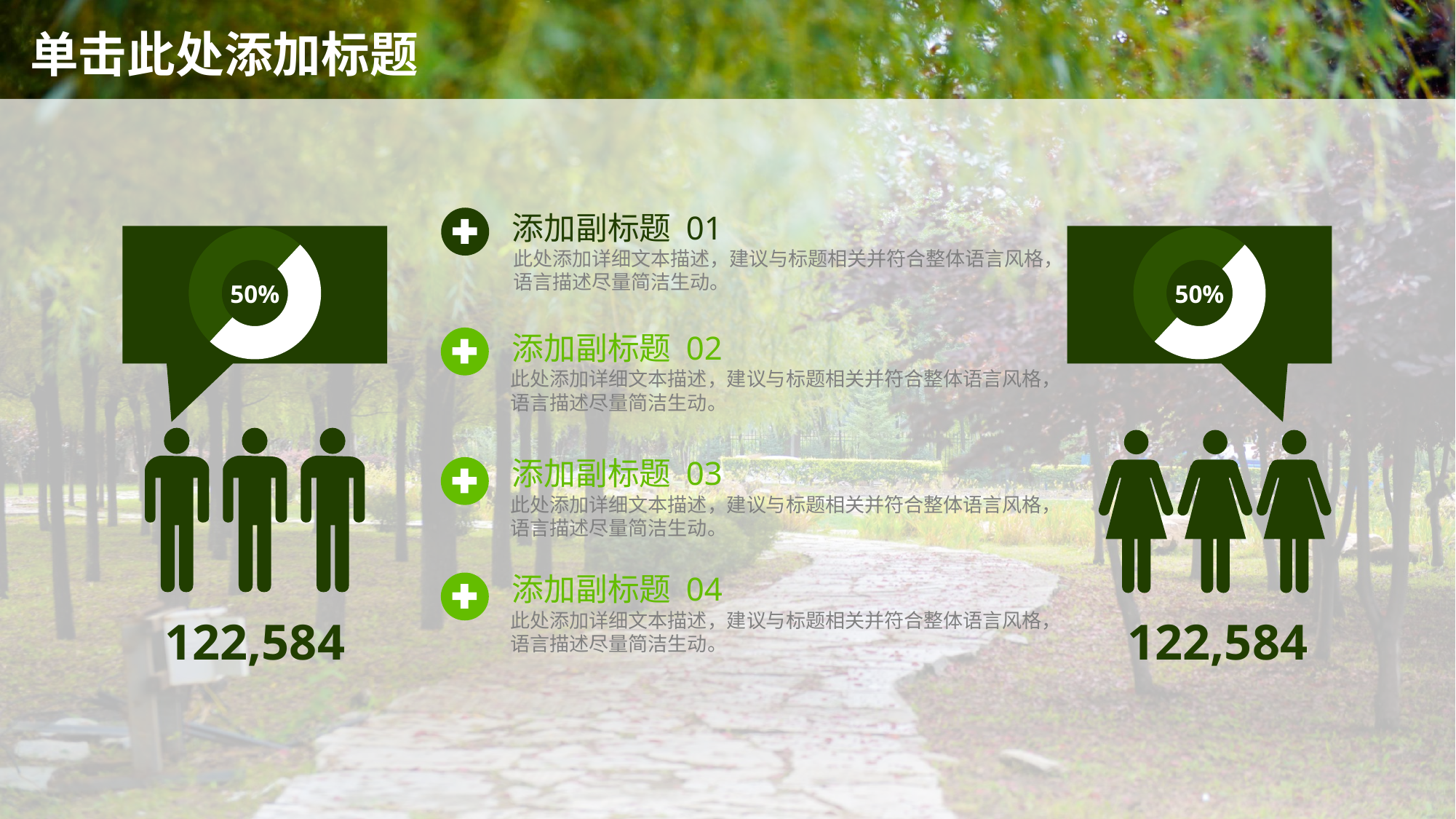
What number is printed below the female figures under the right doughnut chart? 122,584 How many doughnut charts are on the slide? 2 What kind of chart is shown inside the right green callout box above the female figures? doughnut chart What colour is the background box that contains each doughnut chart? dark green What percentage is printed in the centre of the right doughnut chart? 50% What colour is the highlighted 50% slice in the left doughnut chart? white What kind of chart is shown inside the left green callout box above the male figures? doughnut chart What number is printed below the male figures under the left doughnut chart? 122,584 Is the percentage in the left doughnut chart larger than, smaller than, or equal to the percentage in the right doughnut chart? equal What percentage is printed in the centre of the left doughnut chart? 50% How many slices does the left doughnut chart have? 2